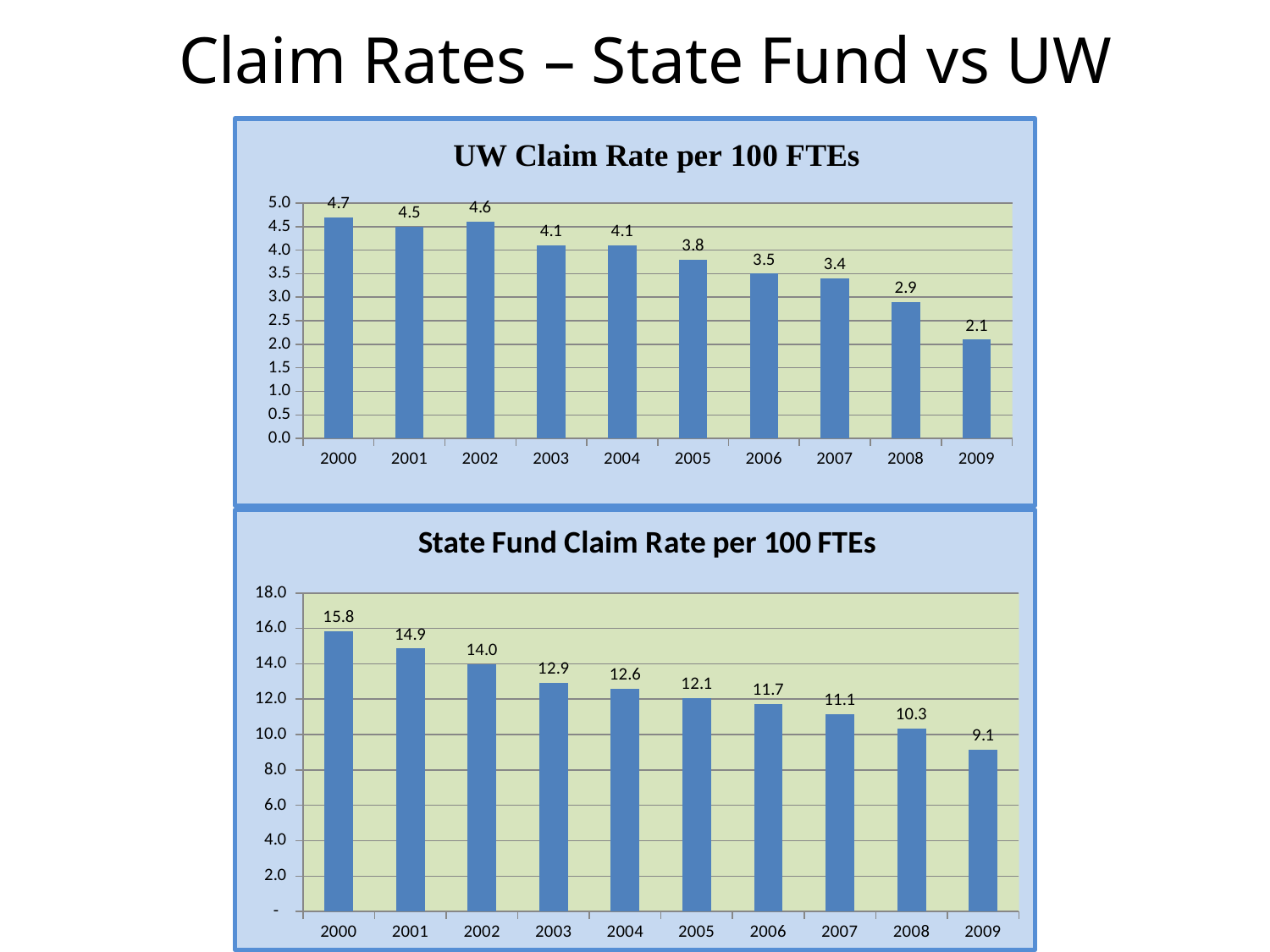
In the 'UW Claim Rate per 100 FTEs' chart, which year has the highest value? 2000 In the 'State Fund Claim Rate per 100 FTEs' chart, which is larger, the value for 2006 or the value for 2007? 2006 In the 'UW Claim Rate per 100 FTEs' chart, is the value for 2008 greater or less than 3.0? less In the 'State Fund Claim Rate per 100 FTEs' chart, what is the difference between the values for 2001 and 2002? 0.9 In the 'State Fund Claim Rate per 100 FTEs' chart, what is the value for 2003? 12.9 What kind of chart is the 'UW Claim Rate per 100 FTEs' chart? bar chart In the 'State Fund Claim Rate per 100 FTEs' chart, do the values rise or fall from 2000 to 2009? fall In the 'UW Claim Rate per 100 FTEs' chart, what is the difference between the values for 2000 and 2009? 2.6 How many years are shown on the x axis of the 'State Fund Claim Rate per 100 FTEs' chart? 10 In the 'UW Claim Rate per 100 FTEs' chart, what is the value for 2005? 3.8 In the 'State Fund Claim Rate per 100 FTEs' chart, which year has the lowest value? 2009 What is the title of the top chart on the slide? UW Claim Rate per 100 FTEs